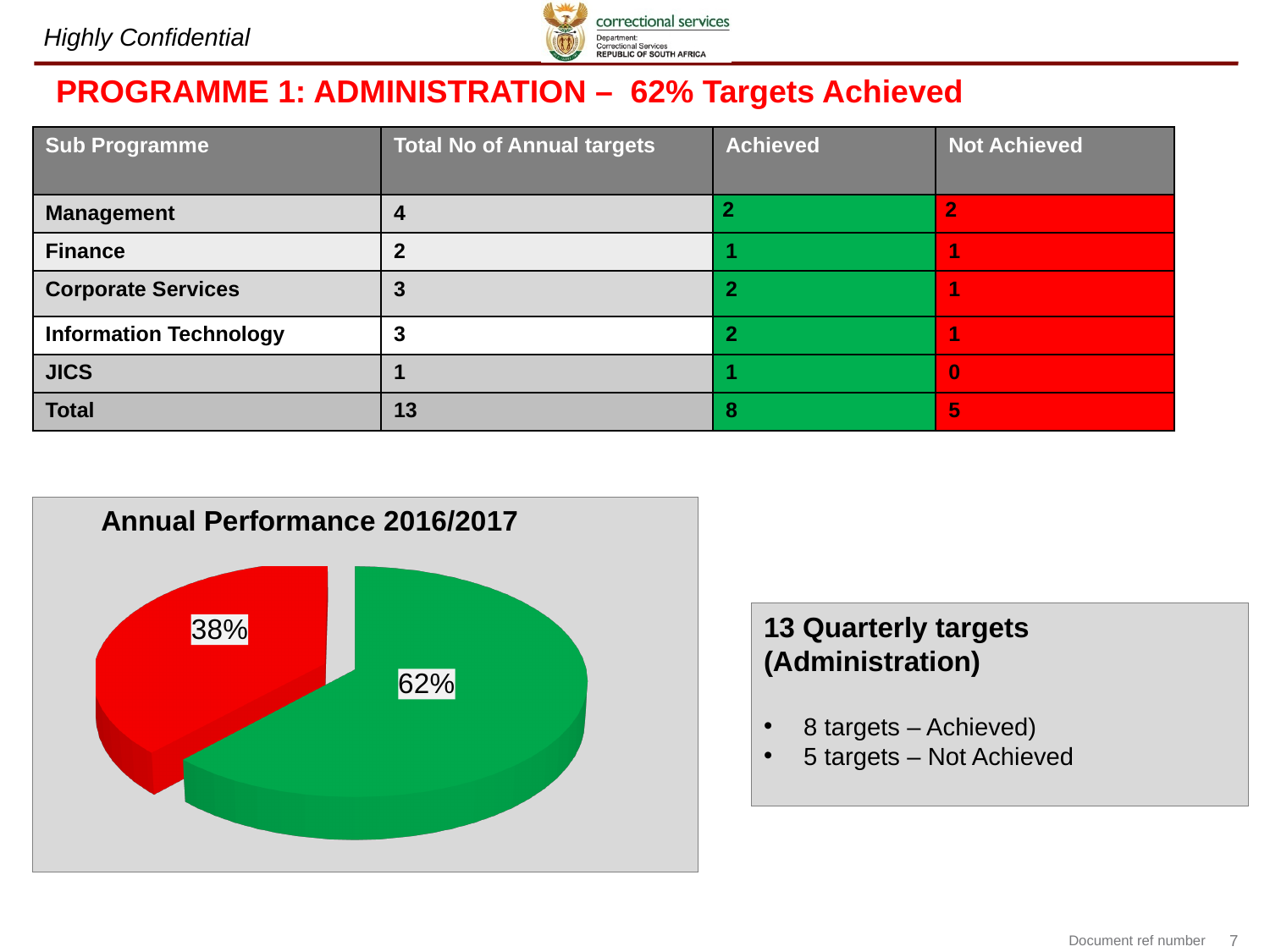
What type of chart is shown on the slide? Pie chart Is the green slice or the red slice larger in the pie chart? The green slice What colours are used for the two slices of the pie chart? Green and red What is the difference in percentage points between the green slice and the red slice? 24 What percentage is shown on the red slice of the pie chart? 38% Which slice of the pie chart is the largest? The green slice (62%) Is the value of the red slice greater or less than 50%? less What percentage is shown on the green slice of the pie chart? 62% What share of the pie does the green slice represent? 62% Which slice of the pie chart is the smallest? The red slice (38%) How many slices does the pie chart have? 2 What is the title of the chart? Annual Performance 2016/2017